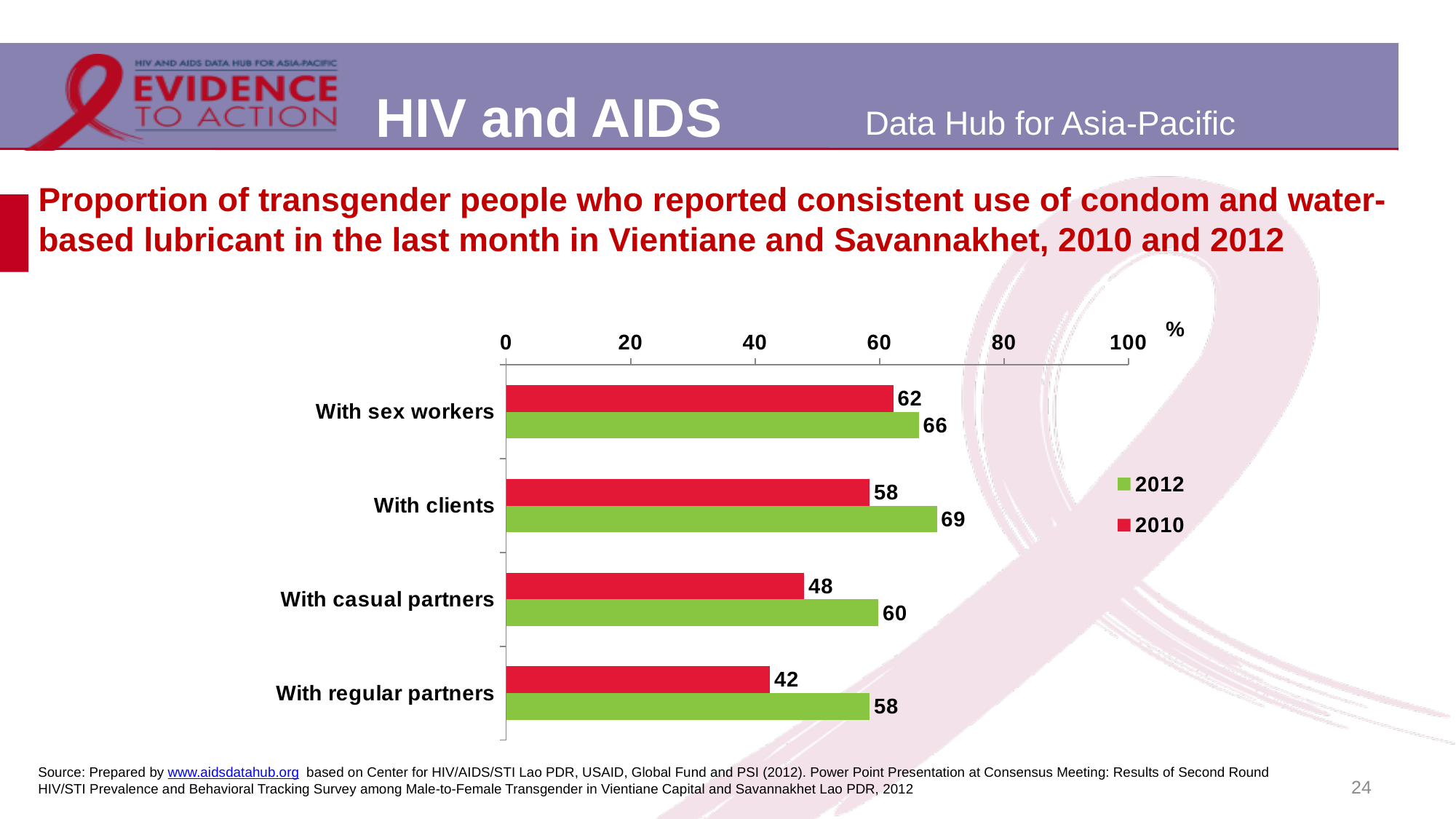
Which is larger: the 2010 value for 'With sex workers' or the 2010 value for 'With clients'? With sex workers What is the difference between the 2012 and 2010 values for 'With clients'? 11 What is the 2010 value for 'With casual partners'? 48 Which category has the lowest 2010 value? With regular partners What is the 2012 value for 'With clients'? 69 How many categories are shown on the chart? 4 How many series does the legend list? 2 Which colour represents the 2012 series? Green What is the 2010 value for 'With regular partners'? 42 What kind of chart is shown on the slide? Bar chart What is the difference between the 2012 and 2010 values for 'With regular partners'? 16 Which category has the highest 2012 value? With clients